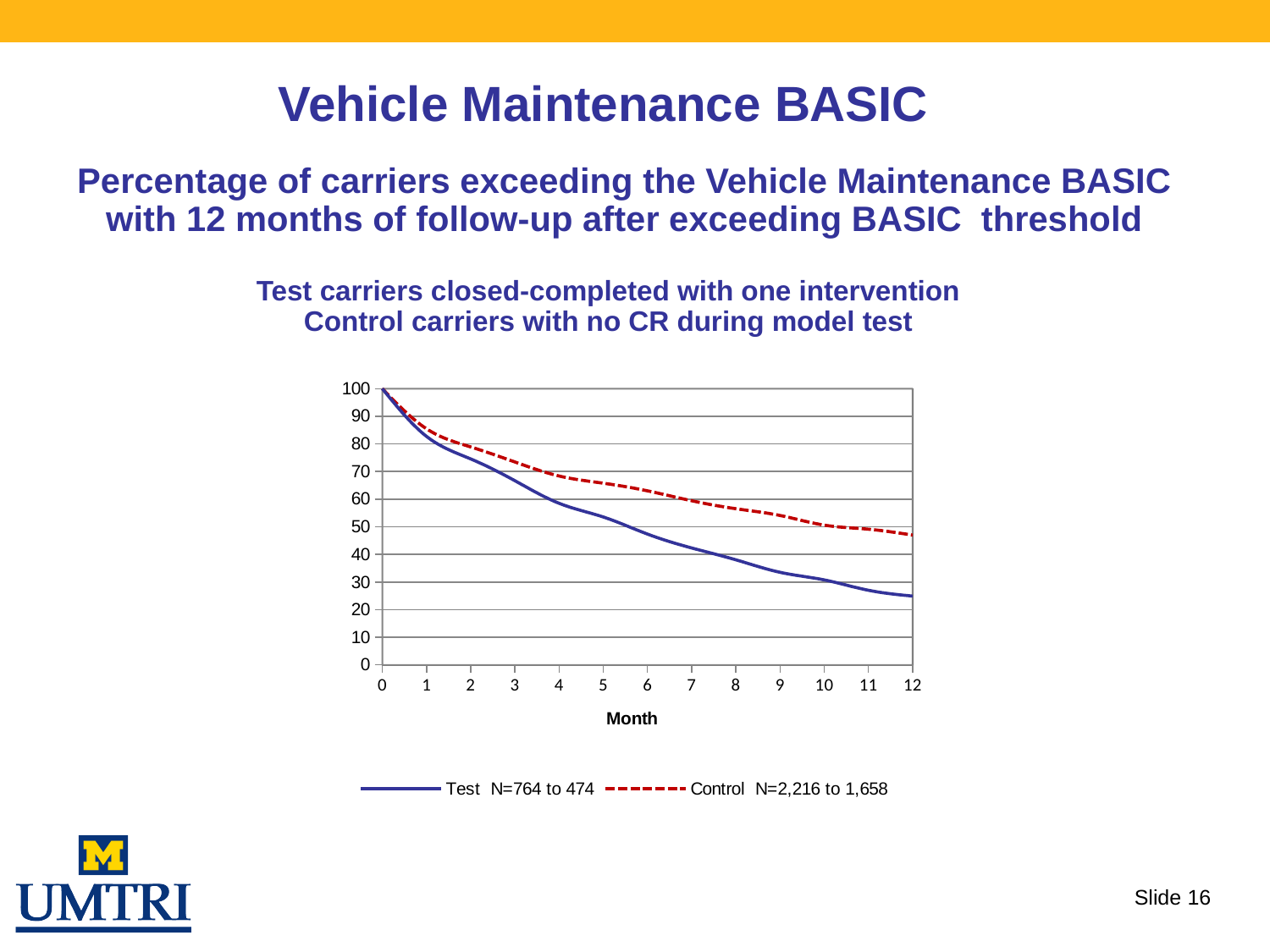
Do the values of the Test series rise or fall as the month increases? fall What kind of chart is shown on the slide? line chart What is the value of the Test series at month 0? 100 At month 12, which series has the higher value, Test or Control? Control Is the value for the Control series at month 4 greater or less than 60? greater How many series does the legend list? 2 Is the value for the Control series at month 12 greater or less than 40? greater Is the value for the Test series at month 12 greater or less than 30? less What is the value of the Control series at month 0? 100 What is the title of the x axis? Month Which series is drawn with a dashed line? Control